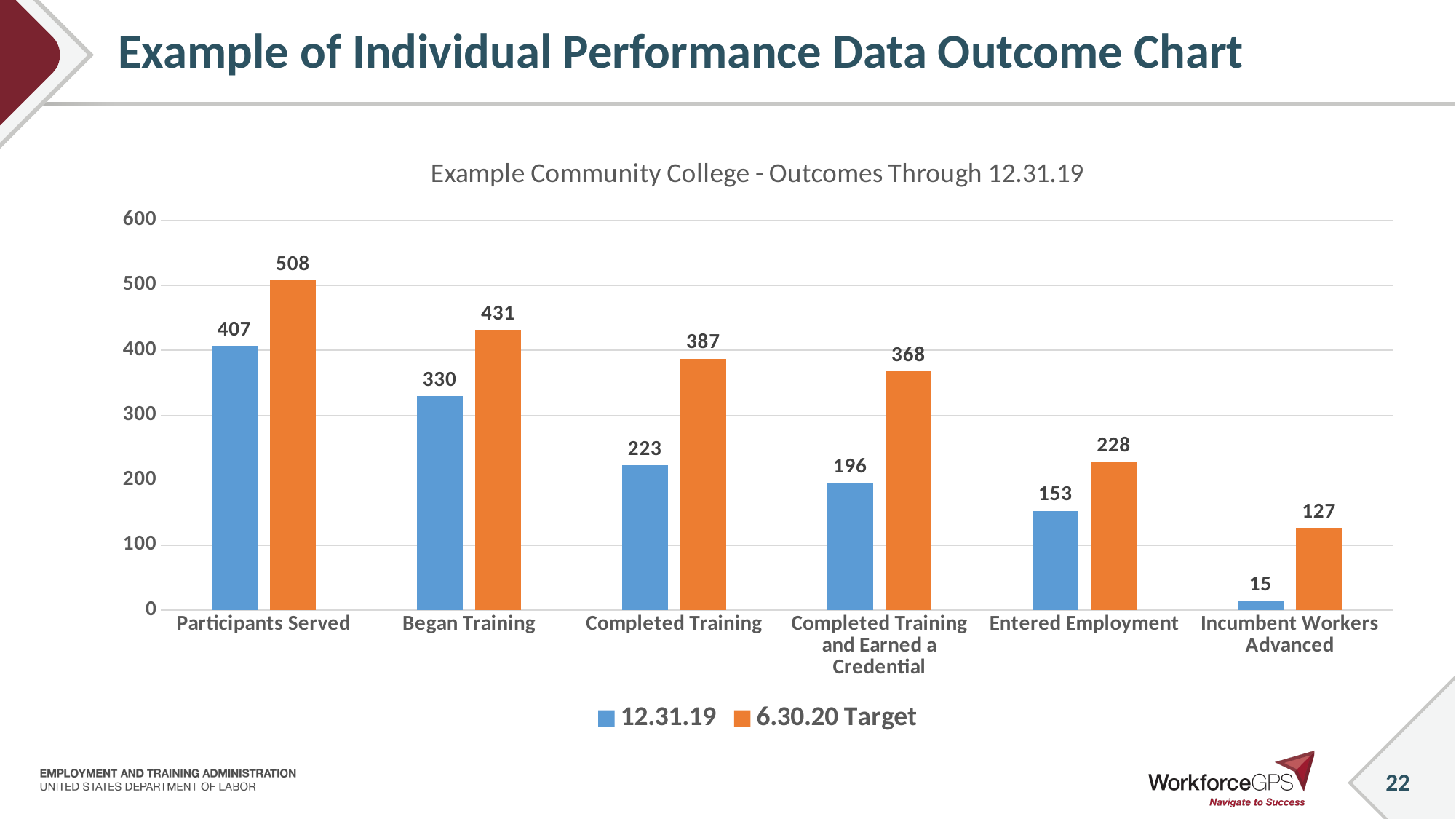
How many series does the legend list? 2 Which category has the lowest 12.31.19 value? Incumbent Workers Advanced Which is larger: the 12.31.19 value for Participants Served or the 6.30.20 Target for Began Training? 6.30.20 Target for Began Training How many categories are shown on the x axis? 6 What is the difference between the 6.30.20 Target and the 12.31.19 value for Completed Training? 164 What is the 12.31.19 value for Incumbent Workers Advanced? 15 What kind of chart is shown on the slide? Bar chart Do the 6.30.20 Target values rise or fall from left to right across the categories? Fall What is the title of the chart? Example Community College - Outcomes Through 12.31.19 Which category has the highest 6.30.20 Target value? Participants Served What is the 6.30.20 Target value for Entered Employment? 228 What is the 12.31.19 value for Began Training? 330